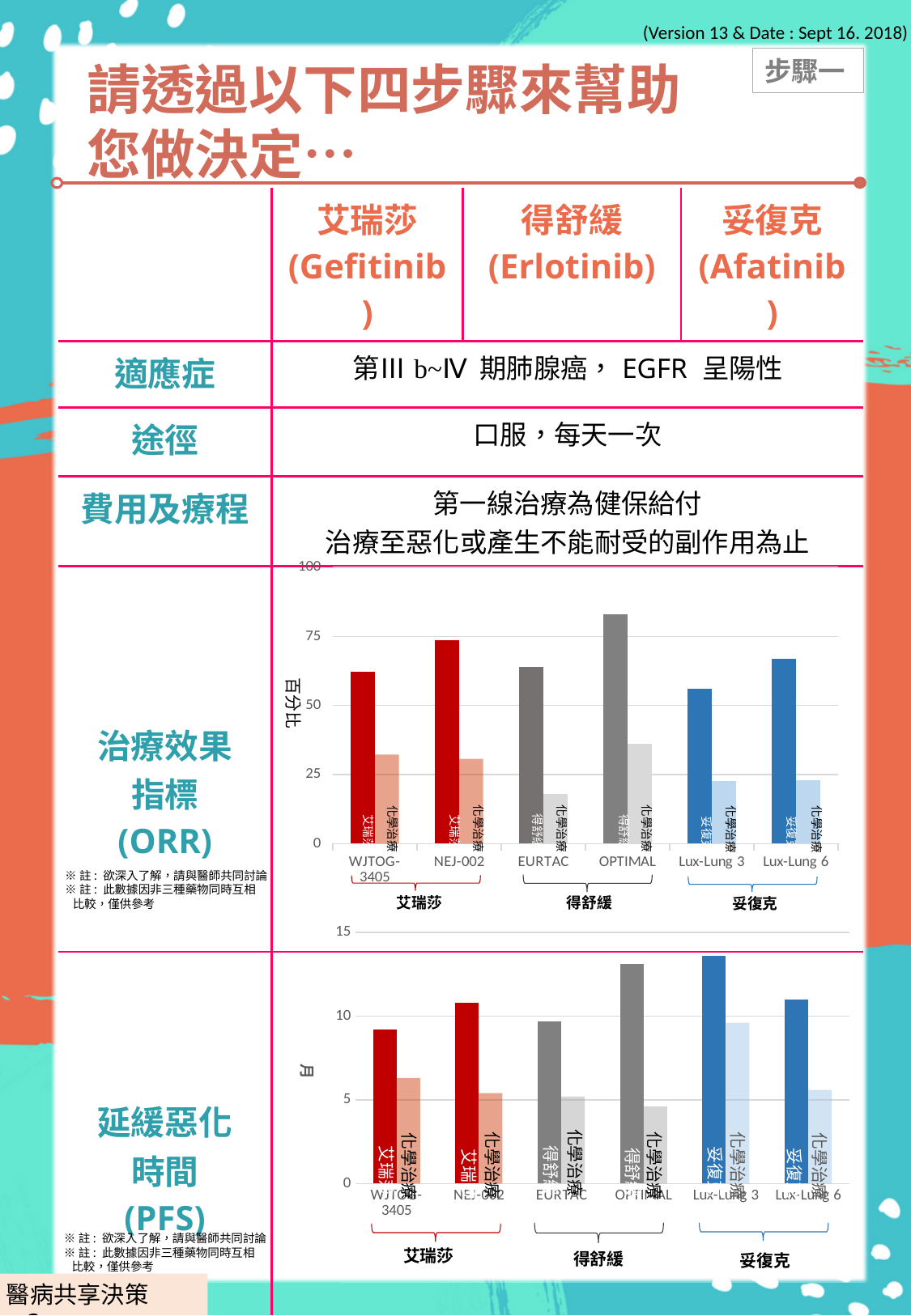
In the top chart (ORR), is the value of the drug bar for WJTOG-3405 greater or less than 50? greater In the bottom chart (PFS), is the value of the drug bar for WJTOG-3405 greater or less than 10? less What is the y-axis label of the bottom chart (PFS)? 月 What is the y-axis label of the top chart (ORR)? 百分比 What kind of chart is the top chart (治療效果指標 ORR)? bar chart How many study categories are shown on the x axis of the top chart (ORR)? 6 In the top chart (ORR), is the value of the 化學治療 bar for EURTAC greater or less than 25? less How many study categories are shown on the x axis of the bottom chart (PFS)? 6 In the top chart (ORR), which is larger: the drug bar for NEJ-002 or the drug bar for WJTOG-3405? NEJ-002 In the top chart (ORR), which study has the highest drug (non-chemotherapy) bar? OPTIMAL